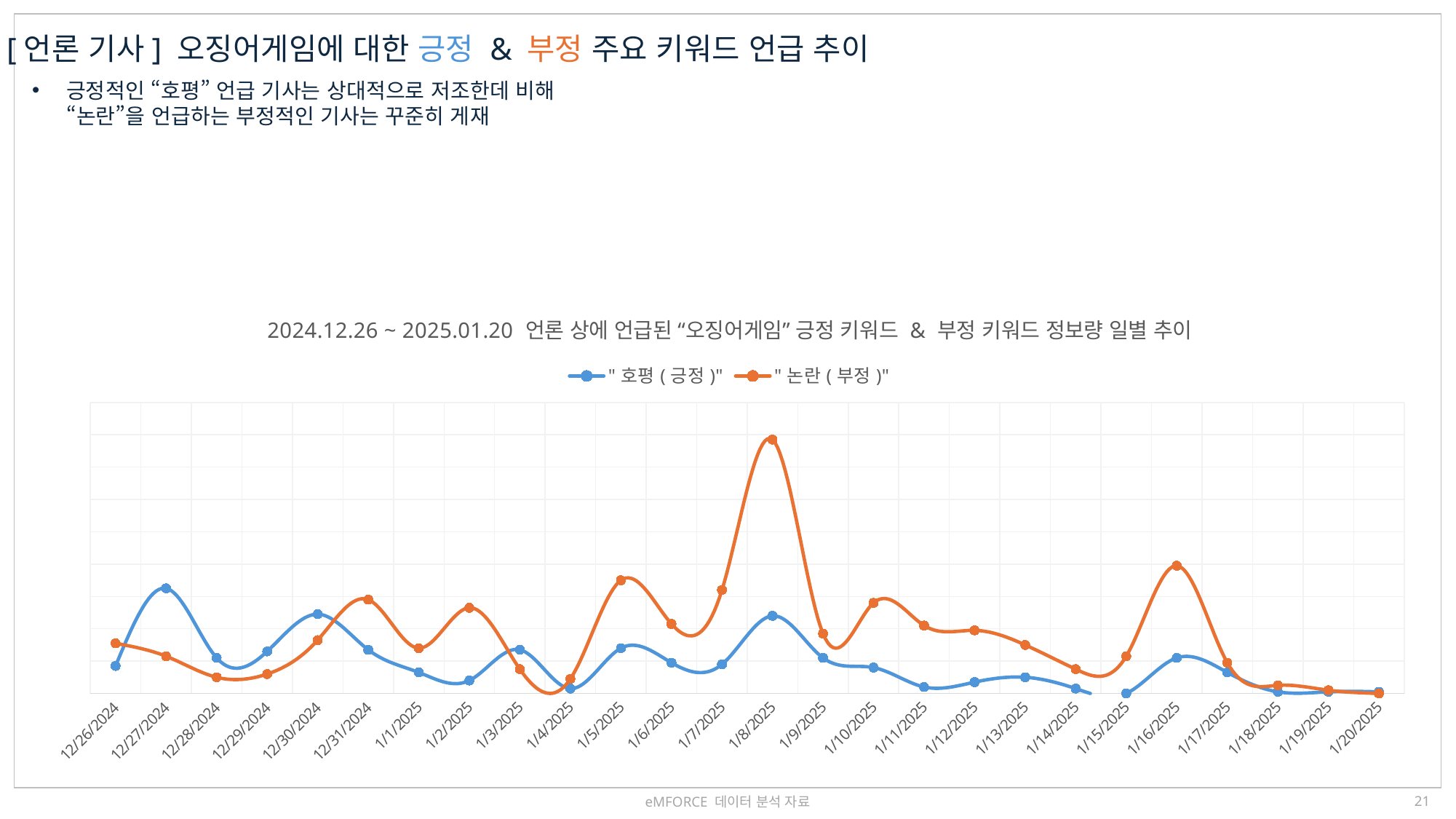
On 1/16/2025, which series has the higher value, " 호평 ( 긍정 )" or " 논란 ( 부정 )"? " 논란 ( 부정 )" On 12/27/2024, which series has the higher value, " 호평 ( 긍정 )" or " 논란 ( 부정 )"? " 호평 ( 긍정 )" Does the " 논란 ( 부정 )" series rise or fall from 1/16/2025 to 1/20/2025? fall On which date does the " 논란 ( 부정 )" series reach its highest value? 1/8/2025 What date range is given in the chart title? 2024.12.26 ~ 2025.01.20 What kind of chart is shown on the slide? line chart On 1/8/2025, which series has the higher value, " 호평 ( 긍정 )" or " 논란 ( 부정 )"? " 논란 ( 부정 )" What is the first date shown on the x axis? 12/26/2024 What are the two series named in the legend? " 호평 ( 긍정 )" and " 논란 ( 부정 )" On which date does the " 호평 ( 긍정 )" series reach its highest value? 12/27/2024 How many series does the legend list? 2 How many dates are plotted along the x axis? 26